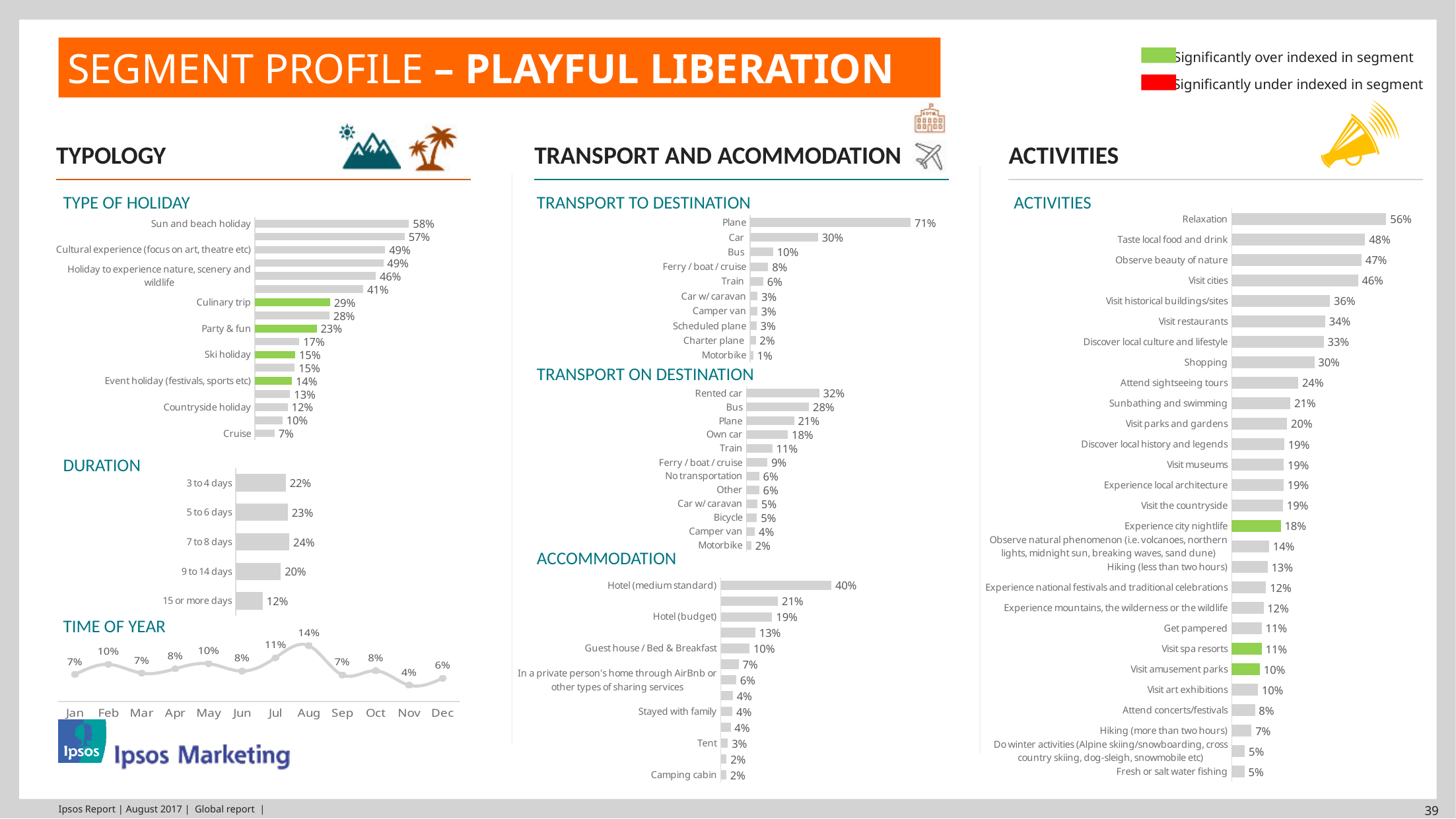
In the Activities chart, which activity has the highest value? Relaxation In the Activities chart, what percentage is shown for Experience city nightlife? 18% In the Time of Year chart, which month has the highest value? Aug In the Transport to Destination chart, which category has the lowest value? Motorbike In the Time of Year chart, what percentage is shown for Nov? 4% In the Duration chart, what percentage is shown for 15 or more days? 12% In the Transport on Destination chart, what is the difference between Rented car and Bus? 4% In the Type of Holiday chart, what percentage is shown for Cruise? 7% In the Duration chart, how many duration categories are shown? 5 In the Accommodation chart, which is larger: Hotel (medium standard) or Hotel (budget)? Hotel (medium standard) In the Transport to Destination chart, what percentage is shown for Plane? 71% What kind of chart is the Time of Year chart? Line chart